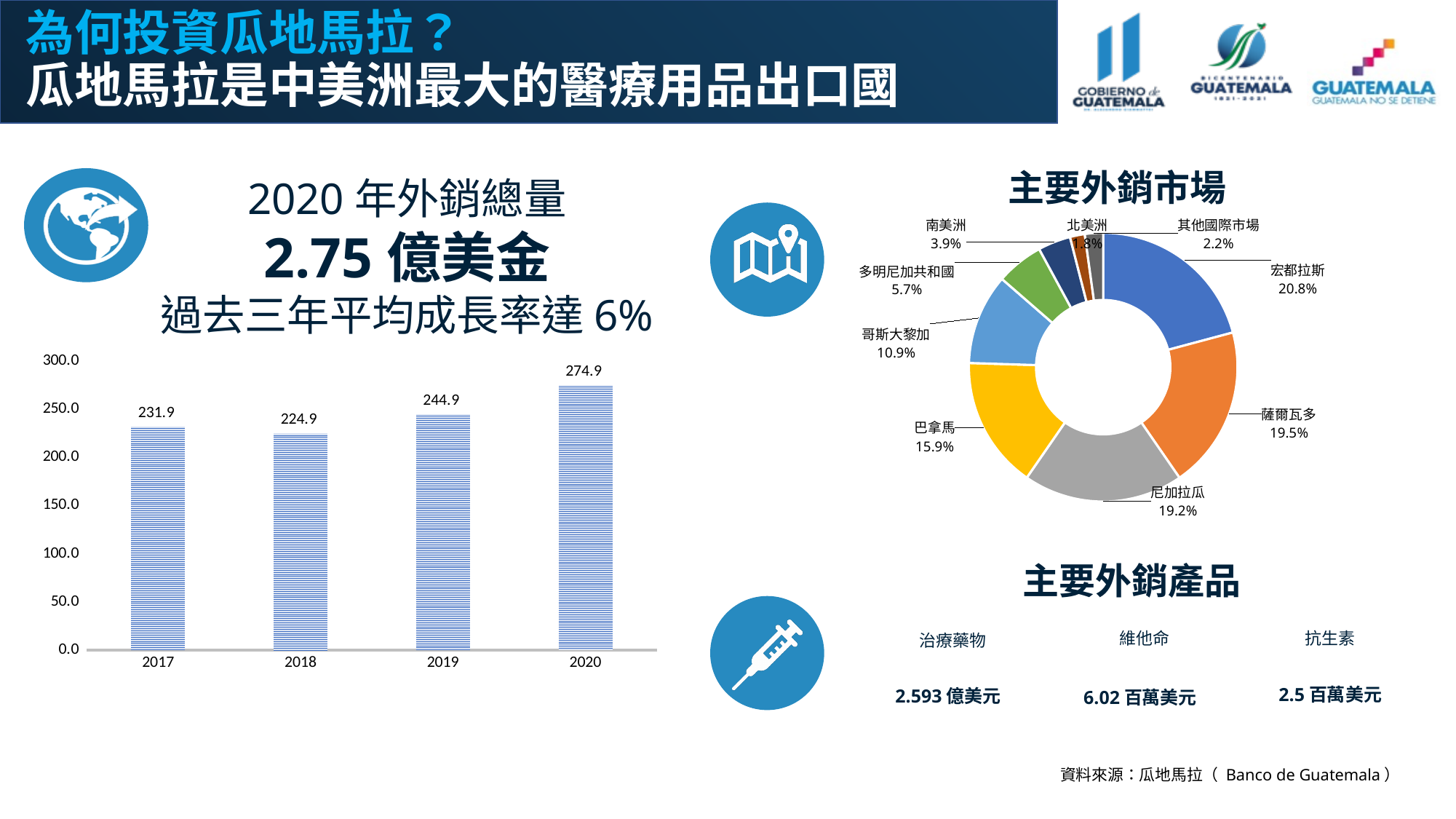
In the bar chart on the left of the slide, how many years are shown on the x axis? 4 In the bar chart on the left of the slide, is the value for 2019 greater or less than 250.0? less In the bar chart on the left of the slide, what is the value for 2018? 224.9 In the chart titled 主要外銷市場, which market has the smallest share? 北美洲 In the bar chart on the left of the slide, what is the value for 2020? 274.9 In the bar chart on the left of the slide, which year has the highest value? 2020 In the chart titled 主要外銷市場, what share does 巴拿馬 have? 15.9% What kind of chart is the chart titled 主要外銷市場? Doughnut (pie) chart In the bar chart on the left of the slide, what is the difference between the 2020 value and the 2017 value? 43.0 In the chart titled 主要外銷市場, how many slices are there? 9 In the bar chart on the left of the slide, which year has the lowest value? 2018 In the chart titled 主要外銷市場, what share does 宏都拉斯 have? 20.8%